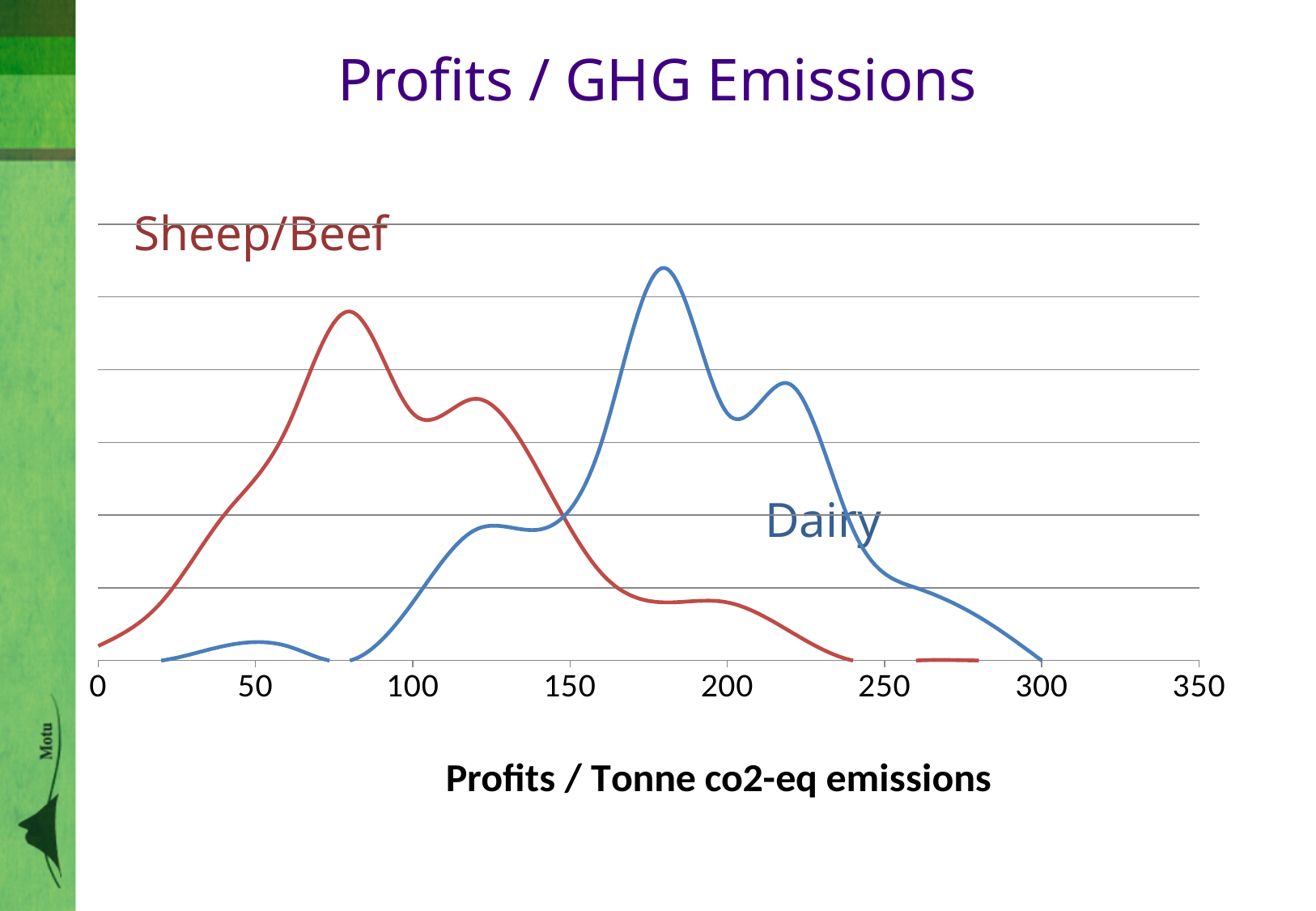
Does the Sheep/Beef curve rise or fall between x = 0 and x = 50? Rise What is the title of the chart? Profits / GHG Emissions What is the largest value shown on the x axis? 350 What kind of chart is shown on the slide? Line chart At an x value of 200, which series is higher, Sheep/Beef or Dairy? Dairy Which series reaches its highest point at a lower x value? Sheep/Beef How many series are plotted on the chart? 2 How many tick labels are shown on the x axis? 8 Which series reaches the higher peak, Sheep/Beef or Dairy? Dairy What is the label on the x axis of the chart? Profits / Tonne co2-eq emissions Does the Dairy curve rise or fall between x = 250 and x = 300? Fall